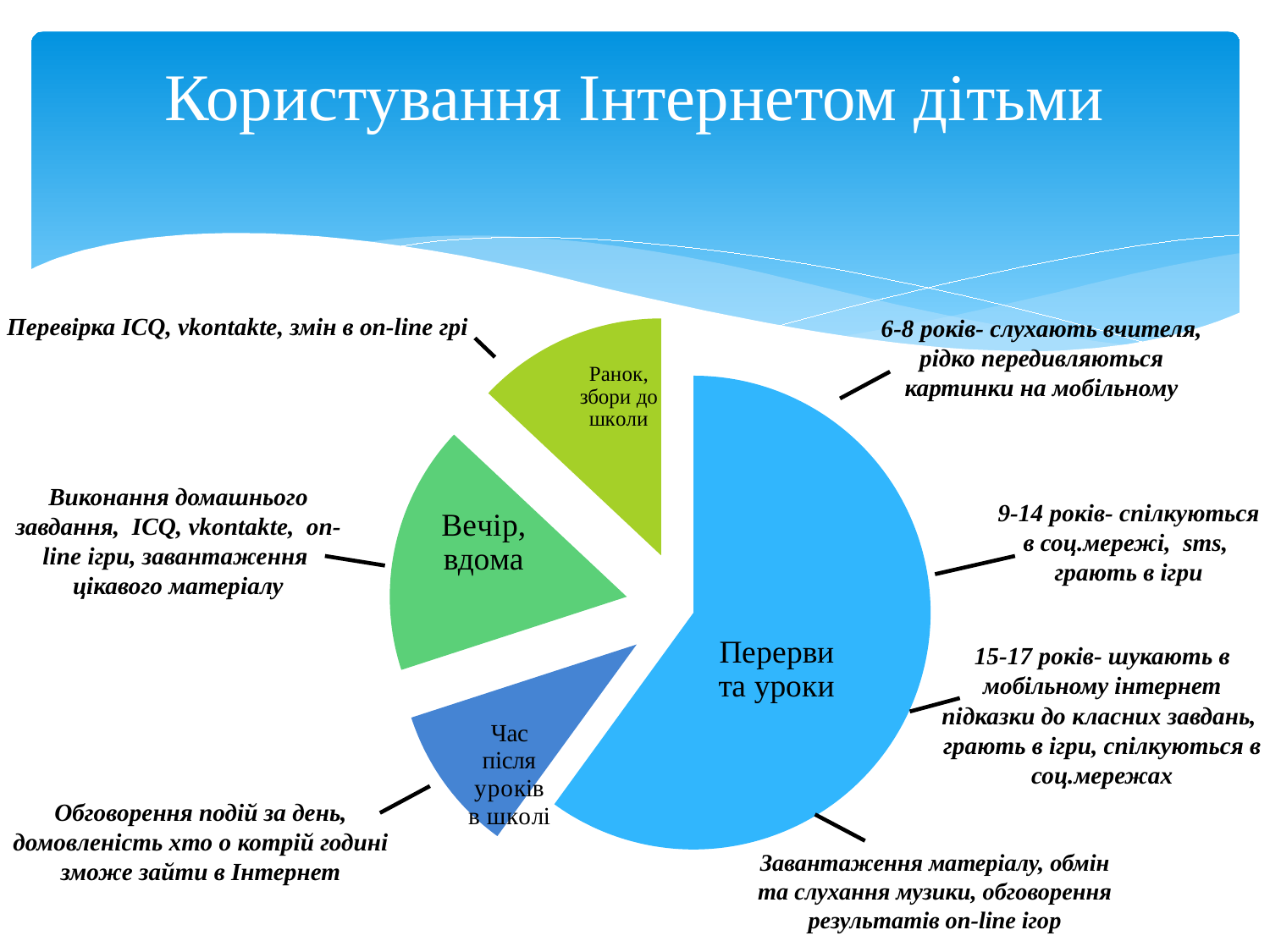
Which is larger: the slice for "Перерви та уроки" or the slice for "Вечір, вдома"? Перерви та уроки What colour is the slice labelled "Вечір, вдома"? green What is the title of the slide containing the pie chart? Користування Інтернетом дітьми What kind of chart is shown on the slide? pie chart How many slices does the pie chart have? 4 Does the slice for "Перерви та уроки" take up more or less than half of the pie? more Which is larger: the slice for "Вечір, вдома" or the slice for "Час після уроків в школі"? Вечір, вдома Which slice of the pie chart is the largest? Перерви та уроки